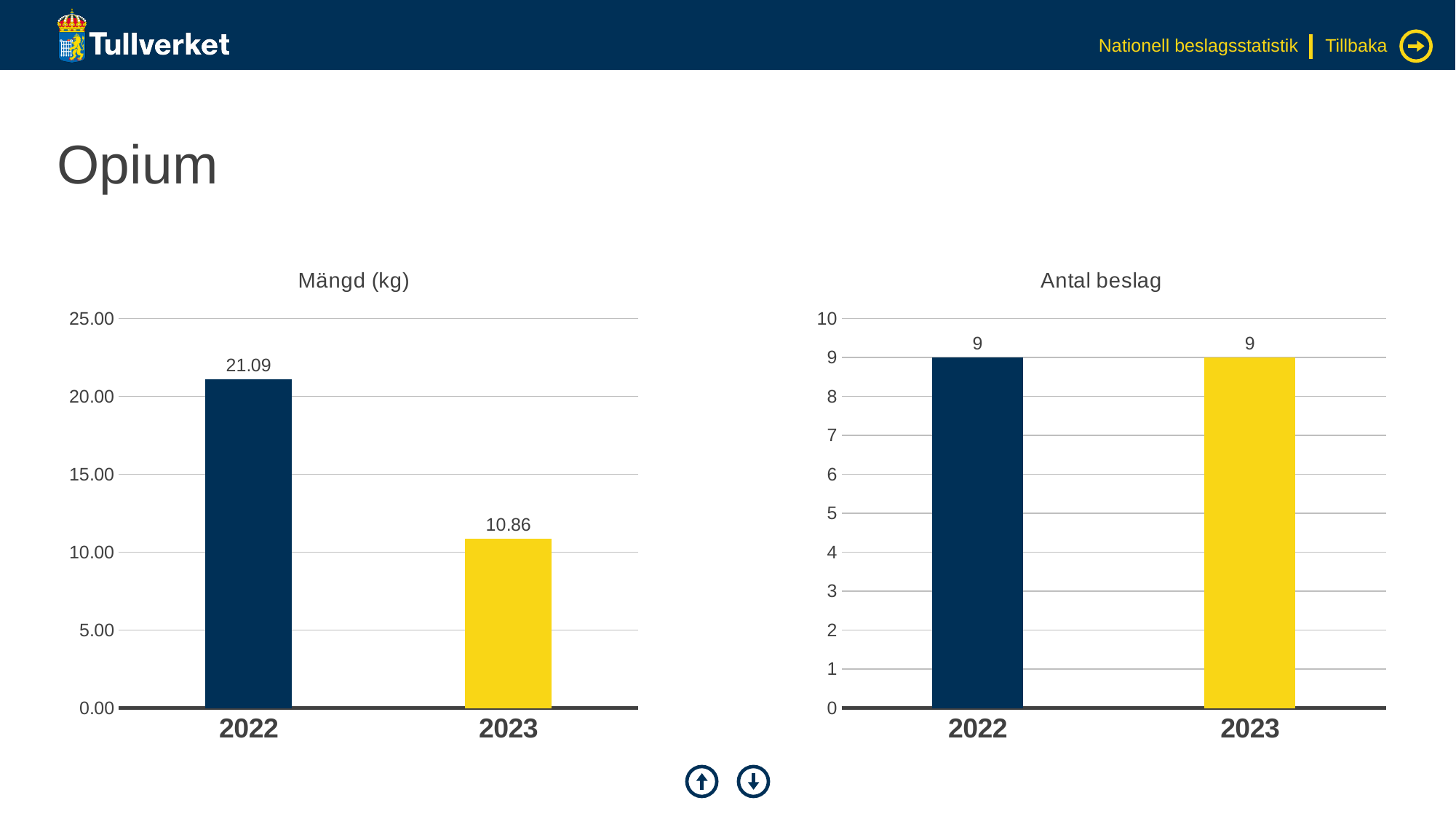
In the 'Mängd (kg)' chart, which year has the lowest value? 2023 How many years are shown in the 'Antal beslag' chart? 2 In the 'Mängd (kg)' chart, which year has the highest value? 2022 In the 'Antal beslag' chart, what is the value for 2022? 9 In the 'Mängd (kg)' chart, do the values rise or fall from 2022 to 2023? fall In the 'Mängd (kg)' chart, what is the difference between the 2022 and 2023 values? 10.23 In the 'Mängd (kg)' chart, what is the value for 2022? 21.09 In the 'Mängd (kg)' chart, what is the value for 2023? 10.86 What kind of chart is the 'Mängd (kg)' chart? bar chart In the 'Antal beslag' chart, what is the difference between the 2022 and 2023 values? 0 In the 'Mängd (kg)' chart, is the value for 2022 greater or less than 20.00? greater In the 'Antal beslag' chart, what is the value for 2023? 9